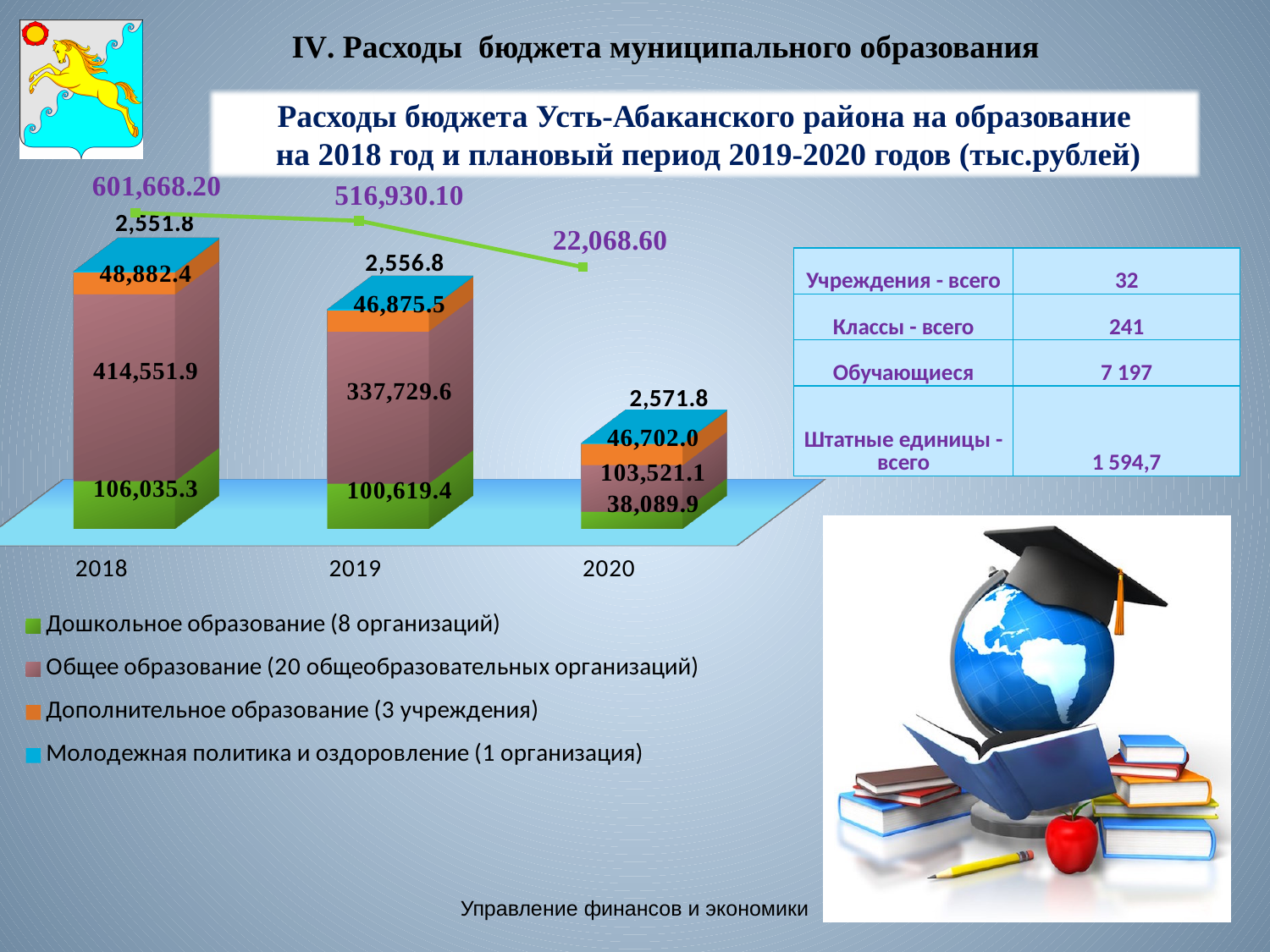
How many series does the chart legend list? 4 Which segment of the 2019 bar has the smallest value? Молодежная политика и оздоровление What is the value for Дополнительное образование in 2019? 46,875.5 Which segment of the 2018 bar has the largest value? Общее образование Which is larger: Дополнительное образование in 2018 or in 2020? 2018 What is the value for Общее образование in 2018? 414,551.9 What is the difference between the Дошкольное образование values for 2018 and 2019? 5,415.9 What is the value for Дошкольное образование in 2020? 38,089.9 How many years are shown on the x axis of the chart? 3 What value is labelled on the line marker above the 2019 bar? 516,930.10 What is the value for Молодежная политика и оздоровление in 2020? 2,571.8 Does the value for Общее образование rise or fall from 2018 to 2020? fall